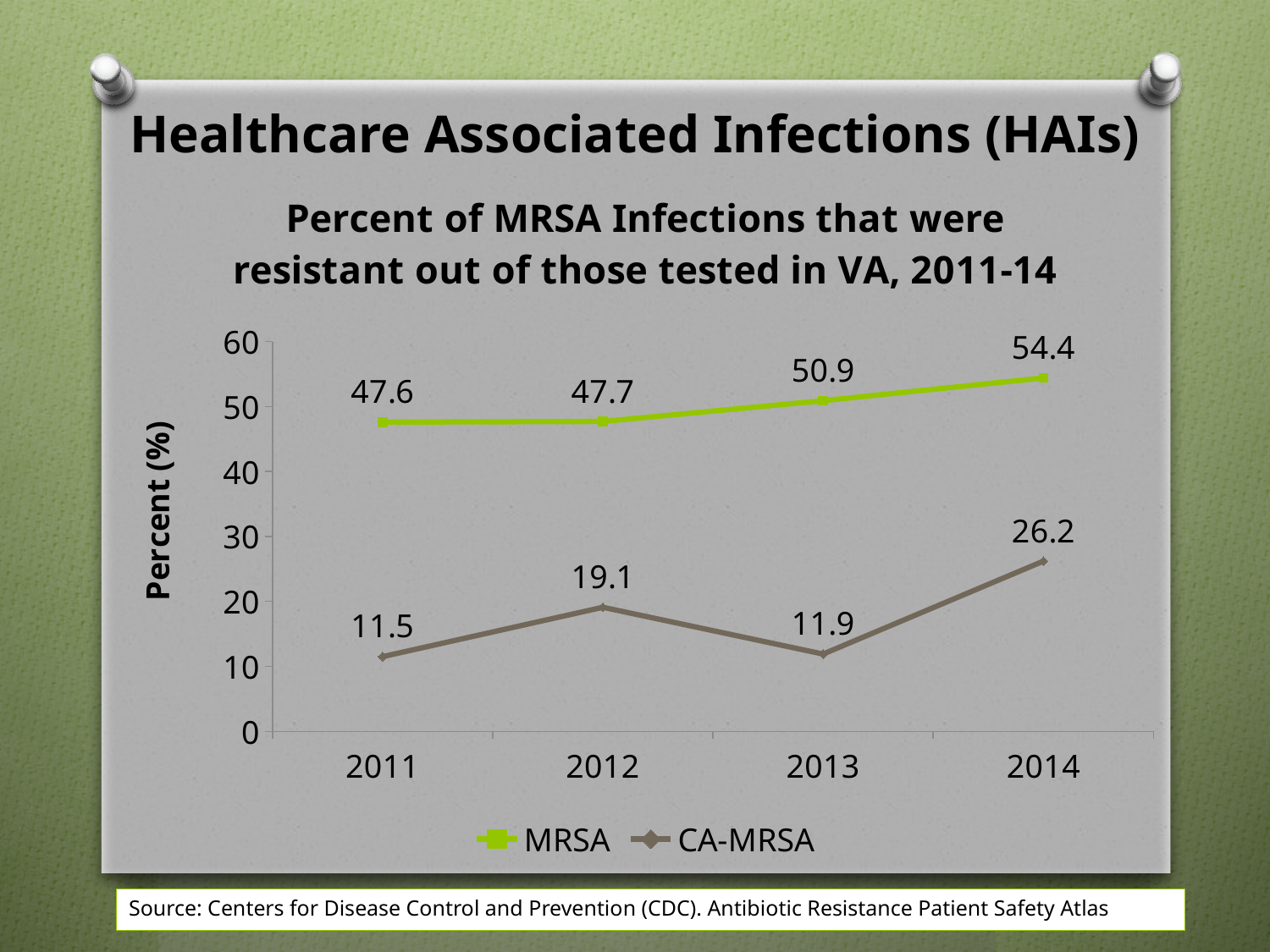
In which year is the CA-MRSA value lowest? 2011 What is the CA-MRSA value for 2012? 19.1 What kind of chart is shown? Line chart What is the MRSA value for 2011? 47.6 What is the MRSA value for 2014? 54.4 What is the difference between the MRSA and CA-MRSA values in 2013? 39 How many years are shown on the x axis? 4 Which is larger, the CA-MRSA value for 2012 or for 2013? 2012 Does the MRSA series rise or fall from 2011 to 2014? Rise Is the CA-MRSA value for 2014 greater or less than 20? greater In which year is the MRSA value highest? 2014 How many series does the legend list? 2